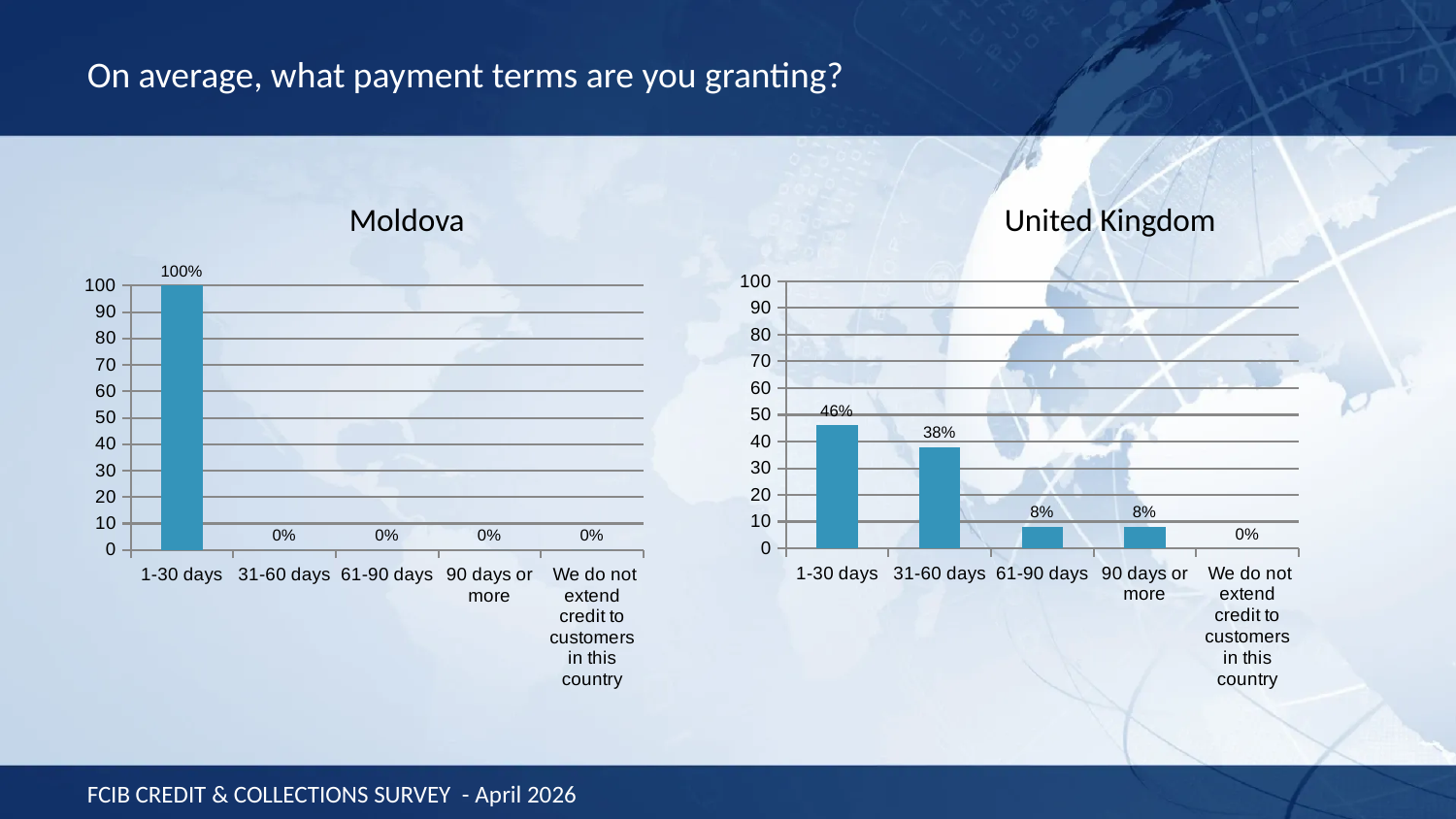
In the United Kingdom chart, is the value for 1-30 days greater or less than 40? greater In the United Kingdom chart, what is the value for 31-60 days? 38% What kind of chart is the United Kingdom chart? Bar chart In the United Kingdom chart, which is larger: the value for 31-60 days or the value for 90 days or more? 31-60 days What is the title of the chart on the left side of the slide? Moldova In the United Kingdom chart, do the values generally rise or fall from left to right along the x axis? Fall In the Moldova chart, which category has the highest value? 1-30 days In the United Kingdom chart, what is the difference between the values for 1-30 days and 31-60 days? 8% In the United Kingdom chart, what is the value for 61-90 days? 8% How many categories are shown on the x axis of the Moldova chart? 5 In the United Kingdom chart, which category has the highest value? 1-30 days In the Moldova chart, what is the value for 1-30 days? 100%